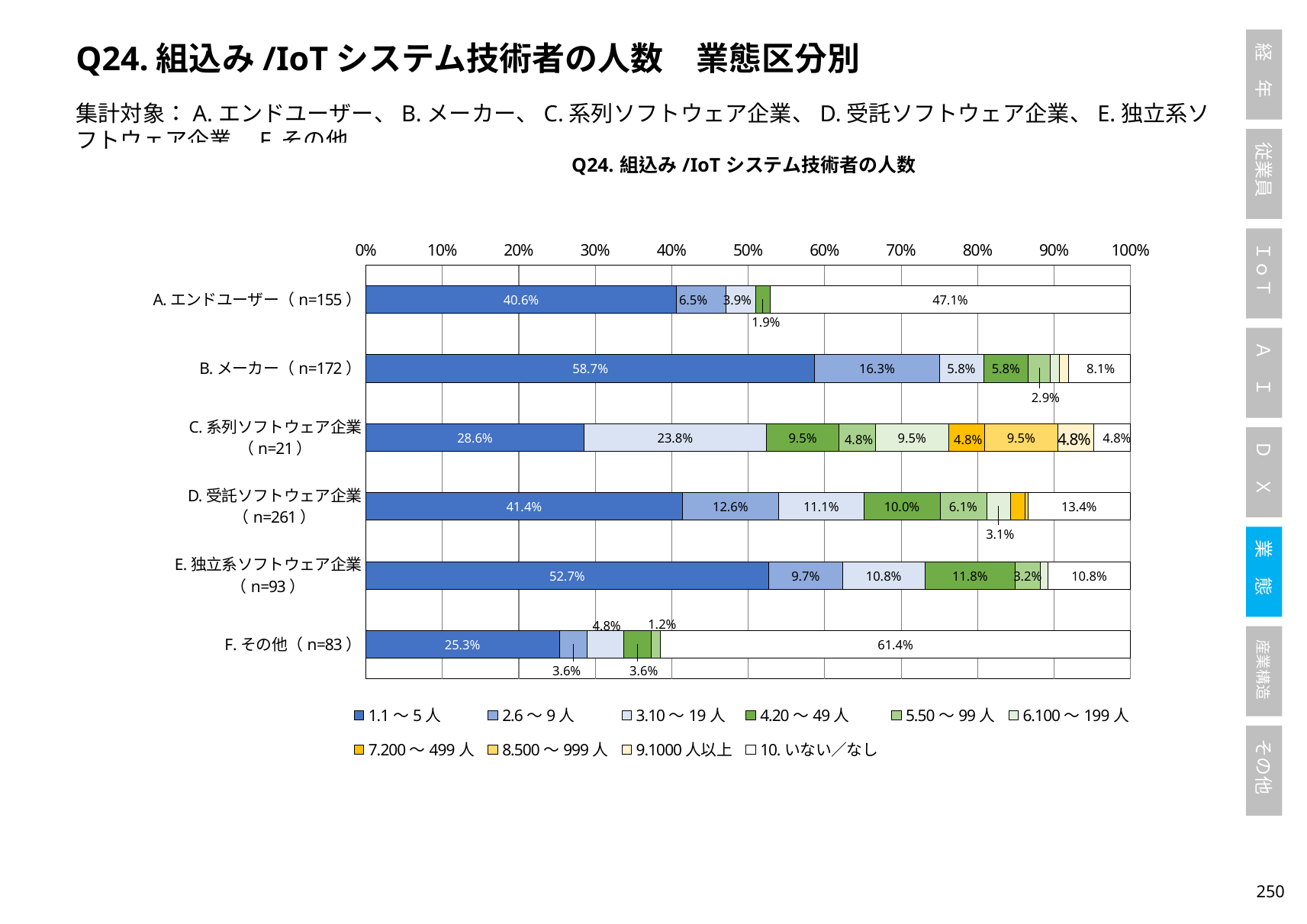
What kind of chart is shown on the slide? Stacked bar chart What is the value of the 2.6～9人 segment for D. 受託ソフトウェア企業 (n=261)? 12.6% What is the value of the 1.1～5人 segment for B. メーカー (n=172)? 58.7% What is the value of the 10. いない／なし segment for F. その他 (n=83)? 61.4% What is the value of the 4.20～49人 segment for E. 独立系ソフトウェア企業 (n=93)? 11.8% Which has a larger 10. いない／なし share: A. エンドユーザー or F. その他? F. その他 How many business-type categories are plotted on the chart? 6 Which category has the highest share for 1.1～5人? B. メーカー (n=172) What is the title of the chart? Q24. 組込み/IoTシステム技術者の人数 How many series does the legend list? 10 What is the difference between the 1.1～5人 share of B. メーカー and that of A. エンドユーザー? 18.1 percentage points Which category has the lowest share for 1.1～5人? F. その他 (n=83)